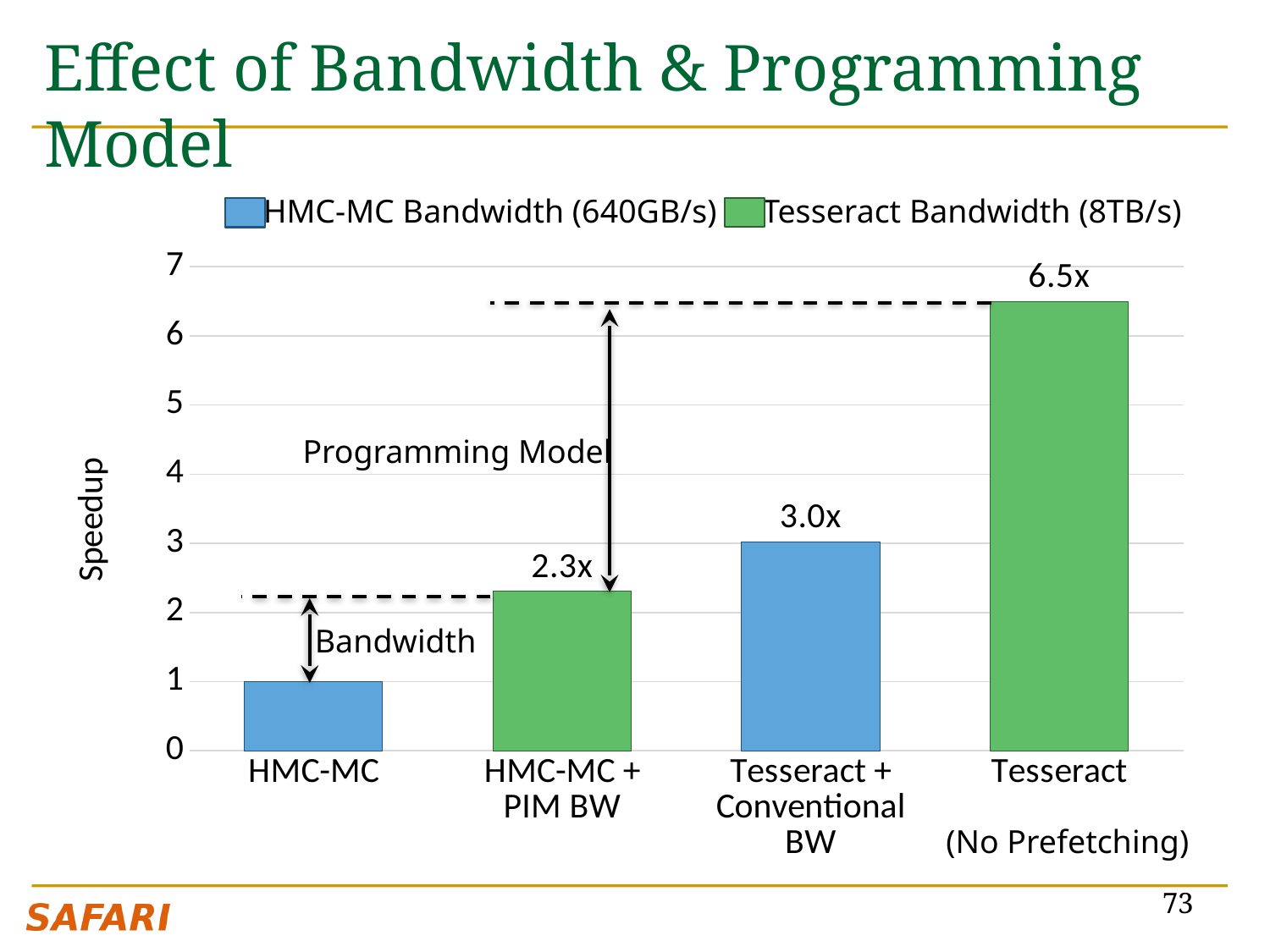
What is the difference in speedup between Tesseract and Tesseract + Conventional BW? 3.5x What is the difference in speedup between Tesseract and HMC-MC + PIM BW? 4.2x How many series does the legend list? 2 What is the speedup shown for HMC-MC + PIM BW? 2.3x What is the speedup shown for Tesseract + Conventional BW? 3.0x How many categories are shown on the x axis? 4 Which category has the lowest speedup? HMC-MC Which has a larger speedup, Tesseract + Conventional BW or HMC-MC + PIM BW? Tesseract + Conventional BW What kind of chart is shown on the slide? bar chart Which category has the highest speedup? Tesseract What is the speedup shown for Tesseract? 6.5x Is the speedup for HMC-MC greater or less than 2? less